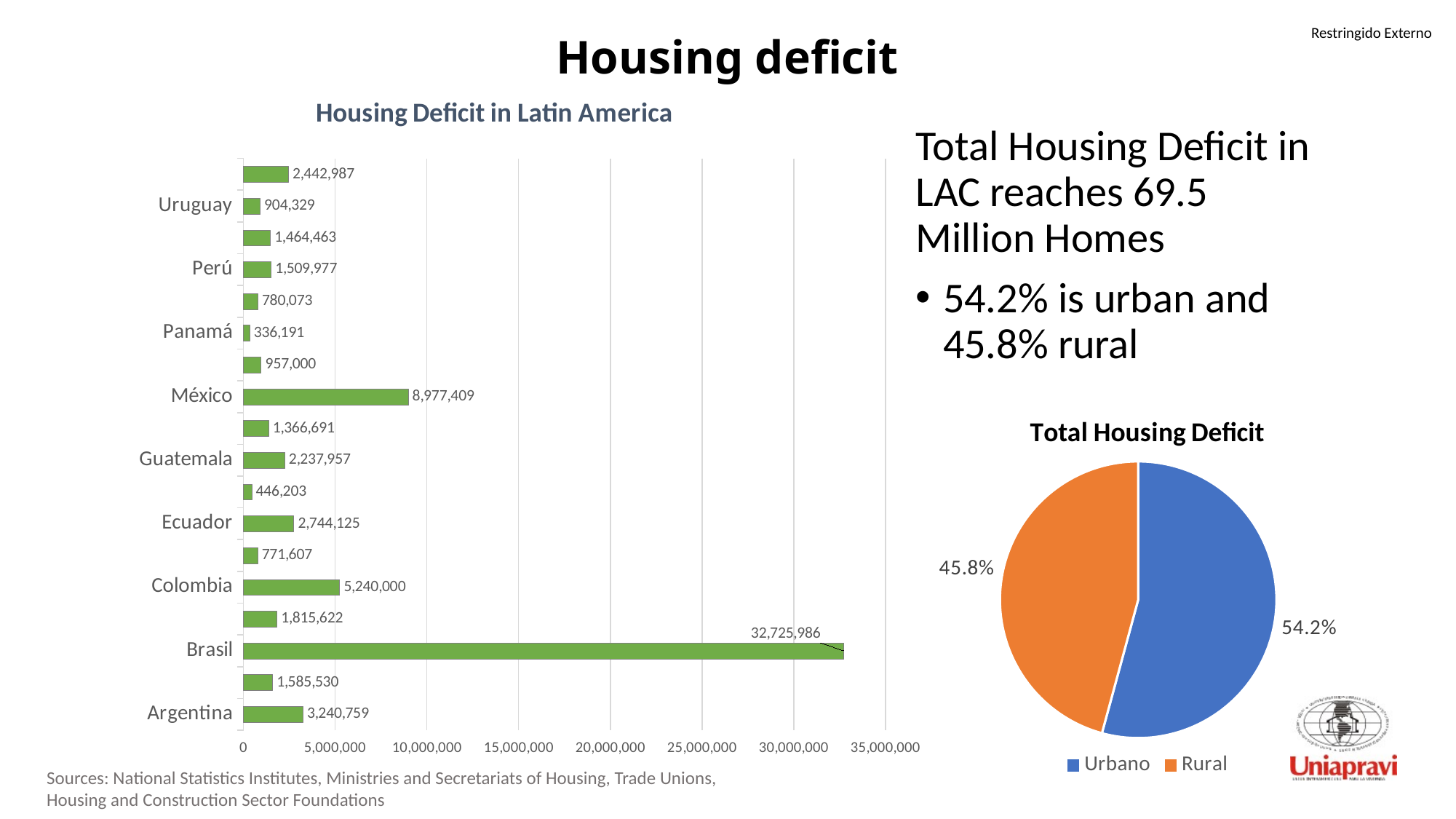
In the 'Housing Deficit in Latin America' chart, what is the value for Panamá? 336,191 In the 'Housing Deficit in Latin America' chart, what is the difference between the values for México and Colombia? 3,737,409 How many series does the legend of the 'Total Housing Deficit' pie chart list? 2 In the 'Housing Deficit in Latin America' chart, what is the value for Colombia? 5,240,000 What kind of chart is 'Housing Deficit in Latin America'? Bar chart In the 'Housing Deficit in Latin America' chart, which labelled country has the highest housing deficit? Brasil In the 'Housing Deficit in Latin America' chart, which is larger, the value for Argentina or the value for Ecuador? Argentina In the 'Total Housing Deficit' pie chart, what share is Rural? 45.8% In the 'Housing Deficit in Latin America' chart, which labelled country has the lowest housing deficit? Panamá In the 'Housing Deficit in Latin America' chart, is the value for Brasil greater or less than 30,000,000? greater In the 'Housing Deficit in Latin America' chart, what is the value for Brasil? 32,725,986 In the 'Housing Deficit in Latin America' chart, what is the value for México? 8,977,409